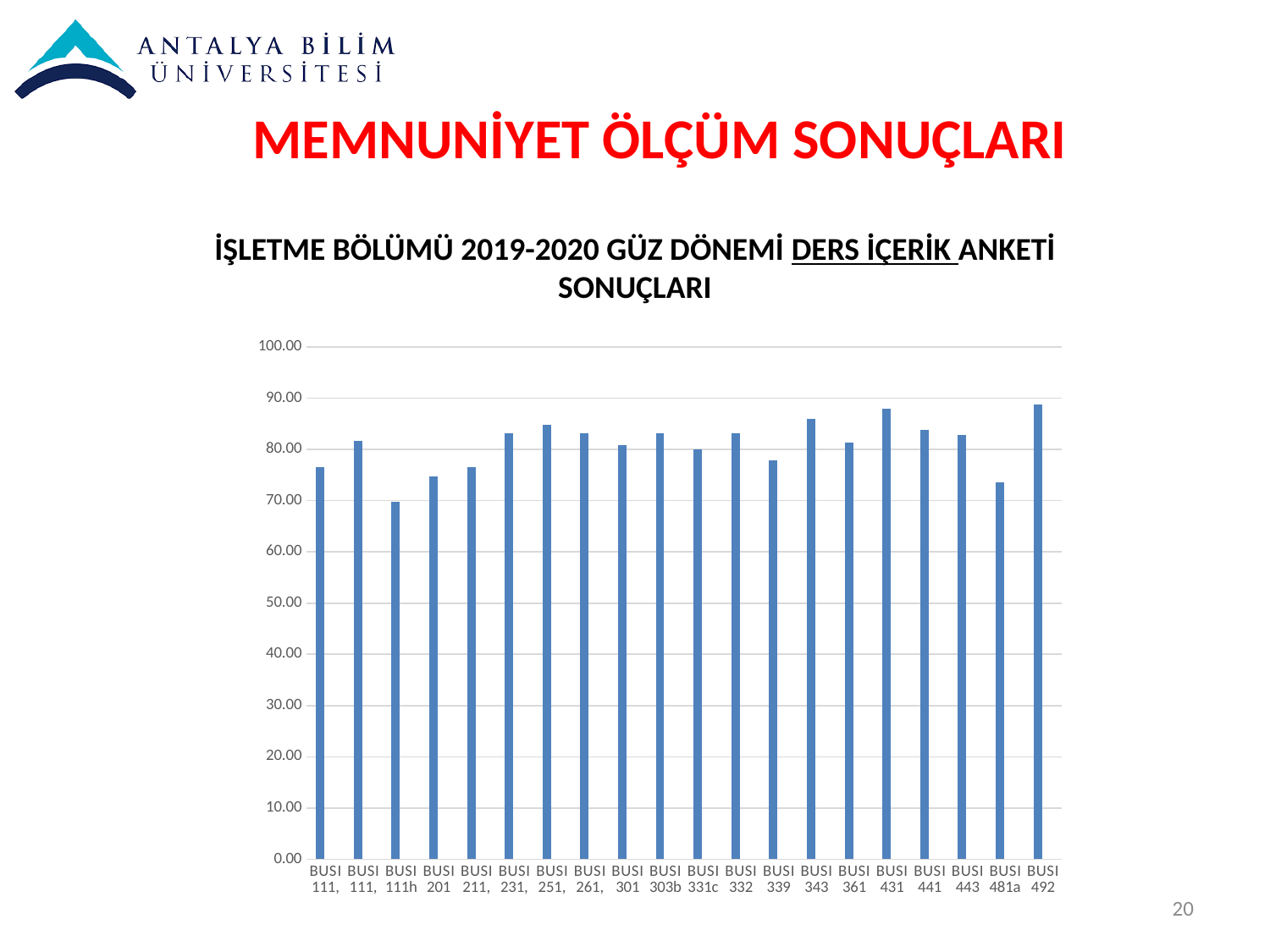
Which course has the lowest value in the chart? BUSI 111h Is the value for BUSI 481a greater or less than 80.00? less Which has the larger value, BUSI 481a or BUSI 441? BUSI 441 Is the value for BUSI 339 greater or less than 80.00? less How many courses (bars) are plotted in the chart? 20 Is the value for BUSI 492 greater or less than 80.00? greater What kind of chart is shown on the slide? Bar chart What is the highest value shown on the vertical axis of the chart? 100.00 Which has the larger value, BUSI 111h or BUSI 201? BUSI 201 Which has the larger value, BUSI 343 or BUSI 339? BUSI 343